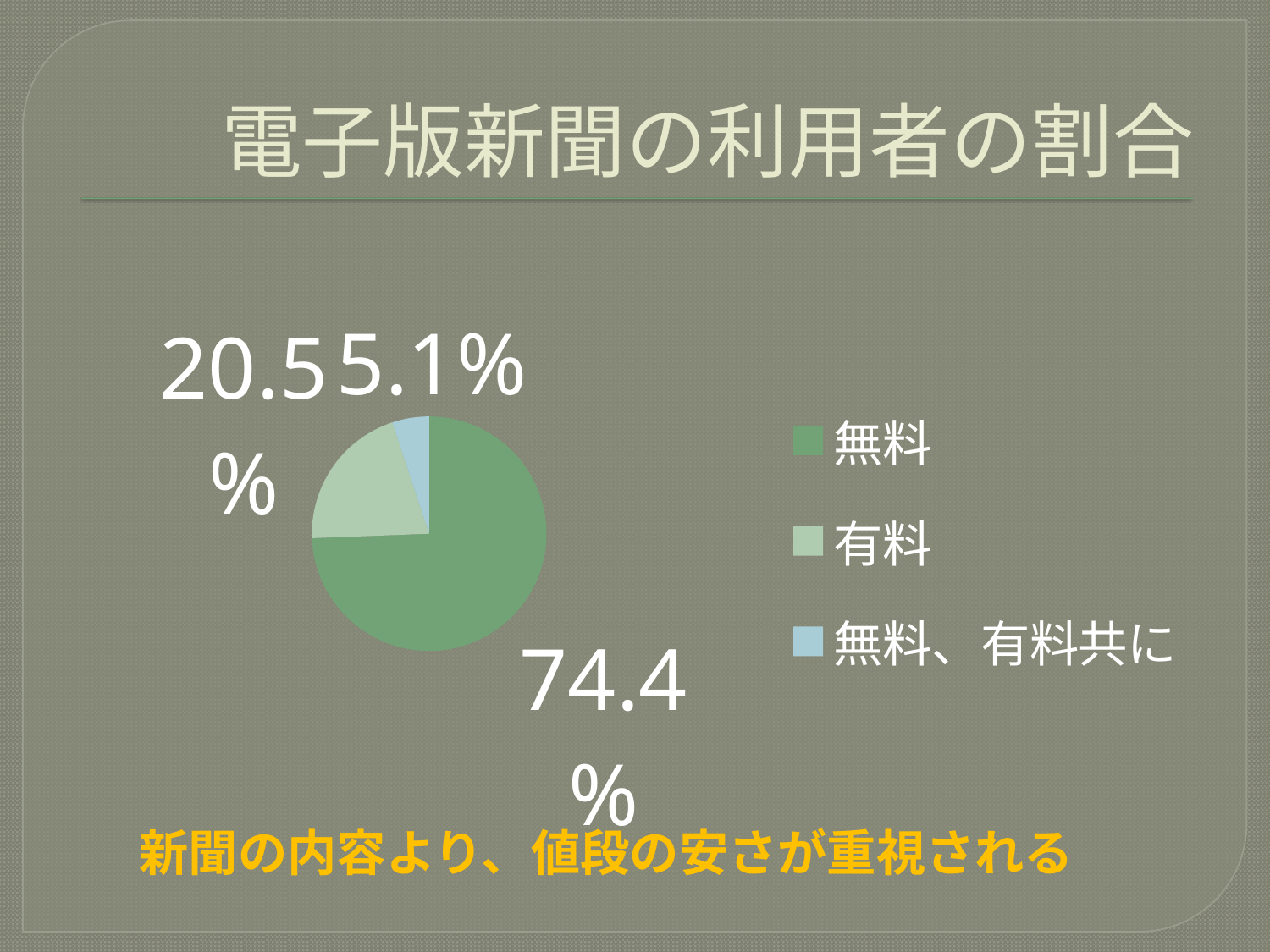
Which legend entry is shown in light blue? 無料、有料共に How many slices does the pie chart have? 3 Which category has the largest share of the pie? 無料 Which category has the smallest share of the pie? 無料、有料共に Which is larger, the share for 有料 or the share for 無料、有料共に? 有料 What is the title of the chart on the slide? 電子版新聞の利用者の割合 What is the difference between the share for 無料 and the share for 有料? 53.9% What is the value for 有料? 20.5% What kind of chart is shown on the slide? pie chart How many entries does the legend list? 3 What is the value for 無料? 74.4% What is the value for 無料、有料共に? 5.1%